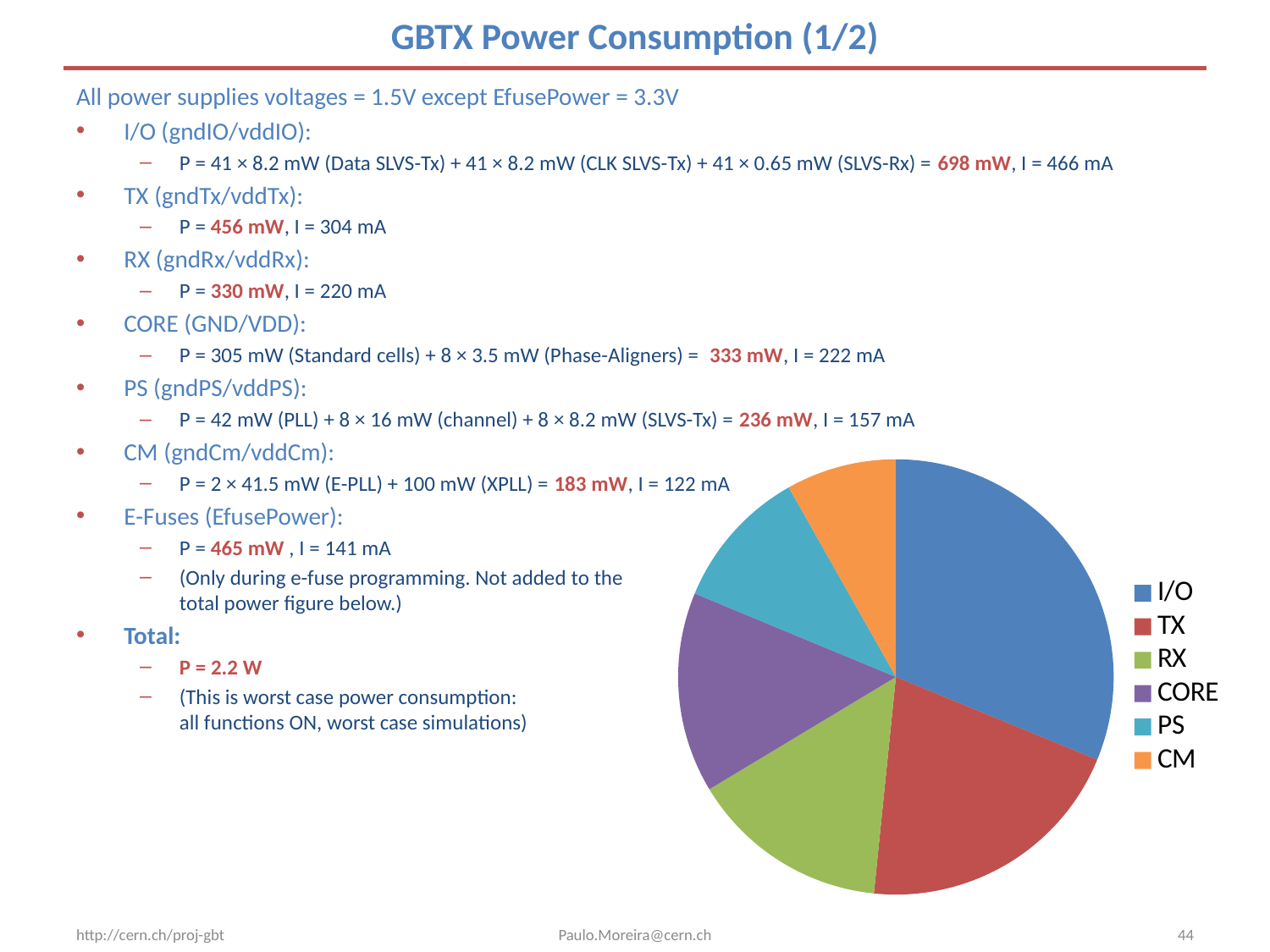
In the pie chart, which slice is larger, TX or RX? TX What colour is the I/O slice in the pie chart? blue Which category has the largest slice in the pie chart? I/O Which legend entry is listed first in the pie chart's legend? I/O What kind of chart is shown on the slide? pie chart How many entries does the pie chart's legend list? 6 In the pie chart, which slice is larger, PS or CM? PS Which category has the smallest slice in the pie chart? CM In the pie chart, which slice is larger, TX or PS? TX How many slices does the pie chart have? 6